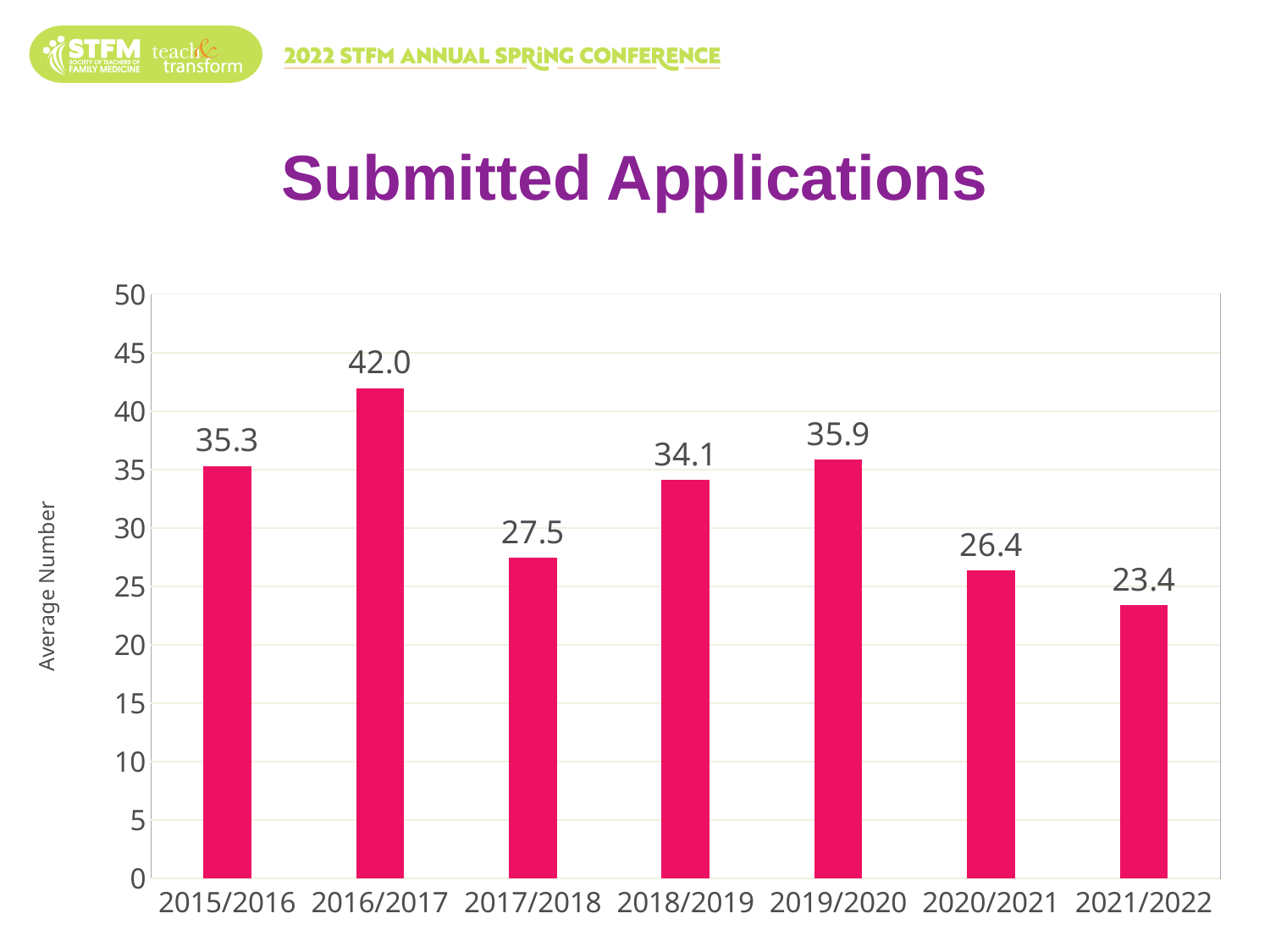
What is the average number of submitted applications for 2021/2022? 23.4 Which is larger, the value for 2015/2016 or the value for 2018/2019? 2015/2016 Is the value for 2020/2021 greater or less than 30? less What is the label of the y axis? Average Number What is the average number of submitted applications for 2016/2017? 42.0 What is the difference between the values for 2016/2017 and 2017/2018? 14.5 Which year has the lowest average number of submitted applications? 2021/2022 Which year has the highest average number of submitted applications? 2016/2017 How many years are shown on the x axis? 7 What is the difference between the values for 2019/2020 and 2020/2021? 9.5 What kind of chart is shown on the slide? bar chart What is the average number of submitted applications for 2018/2019? 34.1